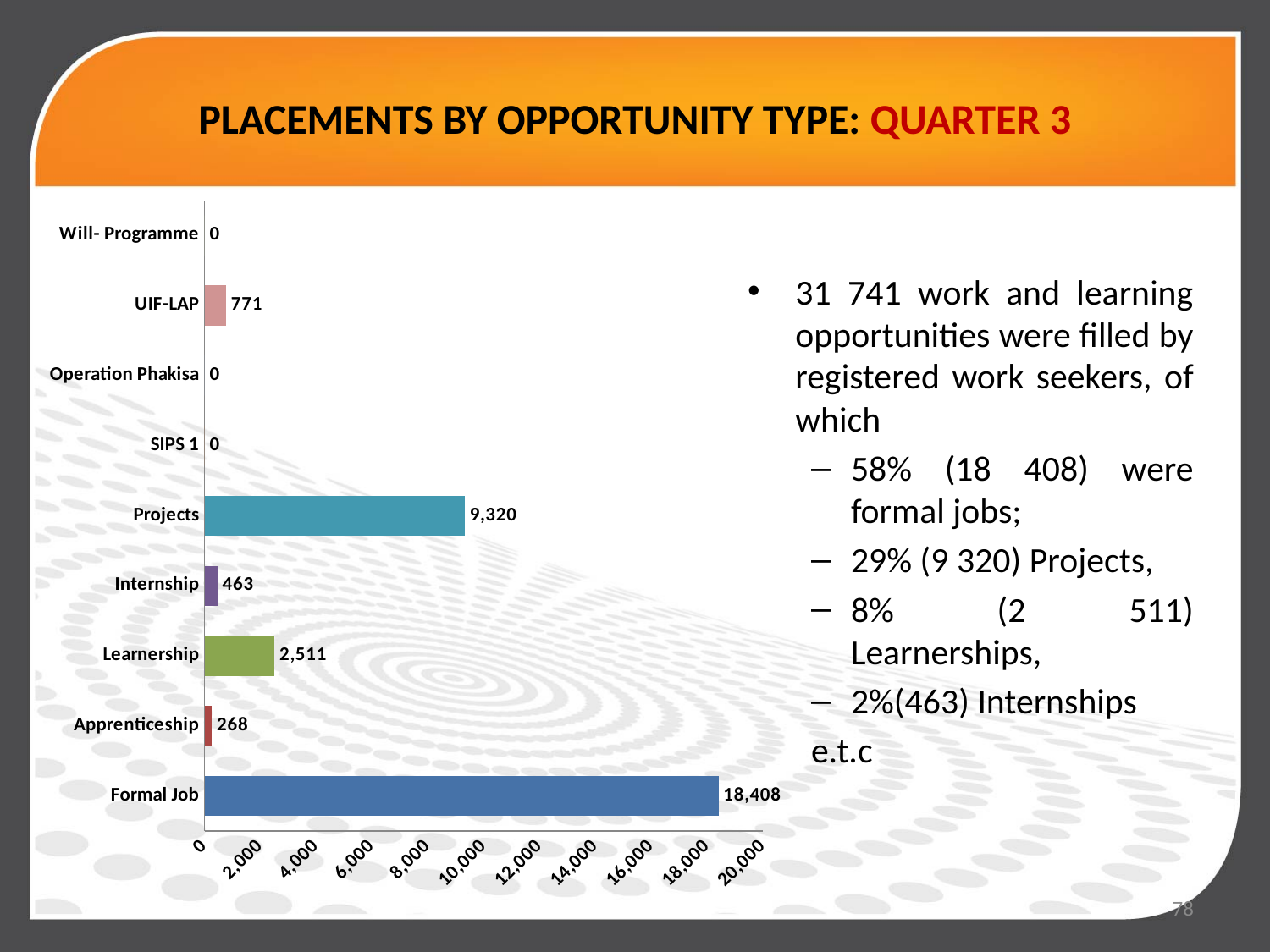
What is the value for Formal Job? 18,408 Which is larger, the value for Internship or the value for Apprenticeship? Internship What is the value for Projects? 9,320 Which opportunity type has the highest number of placements? Formal Job Is the value for Projects greater or less than 10,000? less How many opportunity types are shown on the chart? 9 What is the difference between the values for Formal Job and Projects? 9,088 What kind of chart is shown on the slide? bar chart What is the value for UIF-LAP? 771 What is the title of the slide containing the chart? PLACEMENTS BY OPPORTUNITY TYPE: QUARTER 3 How many opportunity types have a value of 0? 3 What is the value for Learnership? 2,511